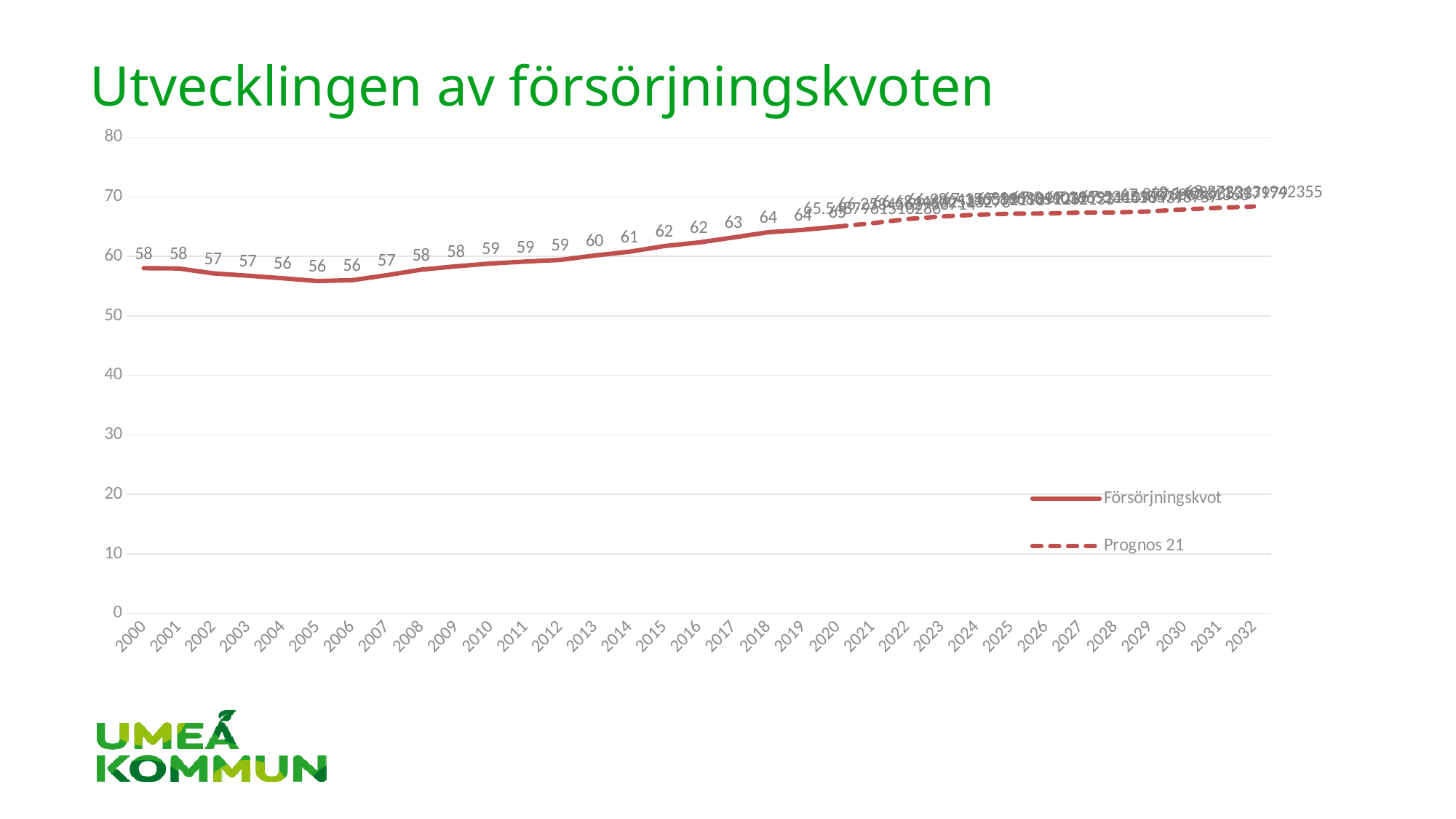
How many years are shown on the x axis? 33 What kind of chart is shown on the slide? line chart Which is larger, the Försörjningskvot value for 2015 or for 2008? 2015 Which series is drawn with a dashed line? Prognos 21 What is the value of Försörjningskvot for 2019? 64 Does the Försörjningskvot line rise or fall between 2006 and 2019? rise What is the value of Försörjningskvot for 2000? 58 What is the value of Försörjningskvot for 2013? 60 What is the value of Försörjningskvot for 2005? 56 How many series does the legend list? 2 What is the difference between the Försörjningskvot values for 2019 and 2000? 6 Is the Prognos 21 value for 2032 greater or less than 70? less